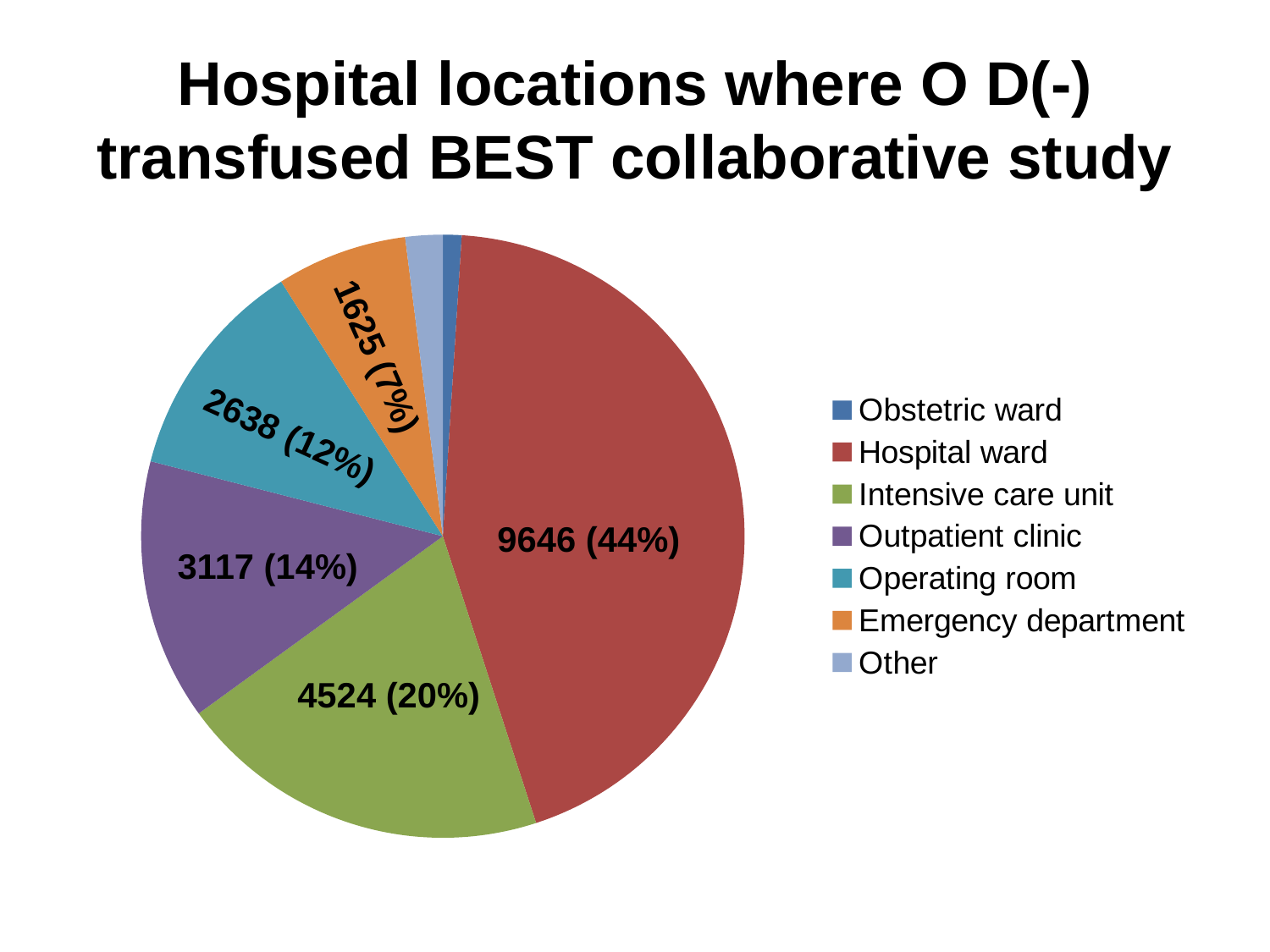
What is the title of the slide? Hospital locations where O D(-) transfused BEST collaborative study Which hospital location has the largest slice of the pie? Hospital ward How many categories does the legend list? 7 What is the value shown for Operating room? 2638 (12%) What is the difference between the Hospital ward value and the Intensive care unit value? 5122 What is the value shown for Outpatient clinic? 3117 (14%) What is the value shown for Hospital ward? 9646 (44%) What share of the pie does Intensive care unit represent? 20% What is the value shown for Intensive care unit? 4524 (20%) What is the value shown for Emergency department? 1625 (7%) What kind of chart is shown on the slide? Pie chart Which is larger, Outpatient clinic or Operating room? Outpatient clinic